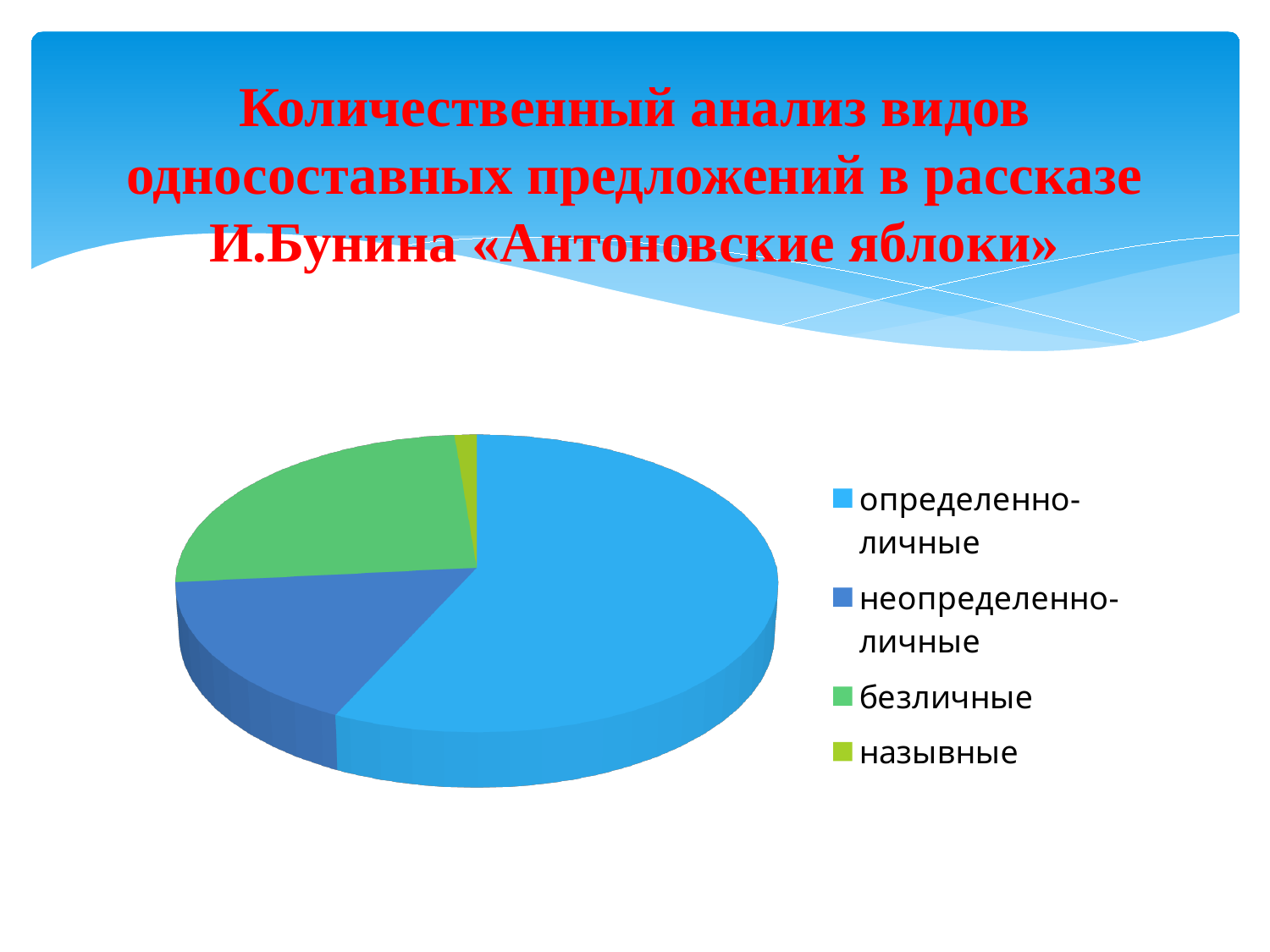
Which slice is larger: неопределенно-личные or назывные? неопределенно-личные How many slices does the pie chart have? 4 What kind of chart is shown on the slide? pie chart What is the title of the slide containing the pie chart? Количественный анализ видов односоставных предложений в рассказе И.Бунина «Антоновские яблоки» Which category has the smallest slice of the pie chart? назывные Which category has the largest slice of the pie chart? определенно-личные Which slice is larger: определенно-личные or безличные? определенно-личные Which slice is larger: безличные or назывные? безличные Which category is shown in green in the pie chart? безличные How many entries does the legend of the pie chart list? 4